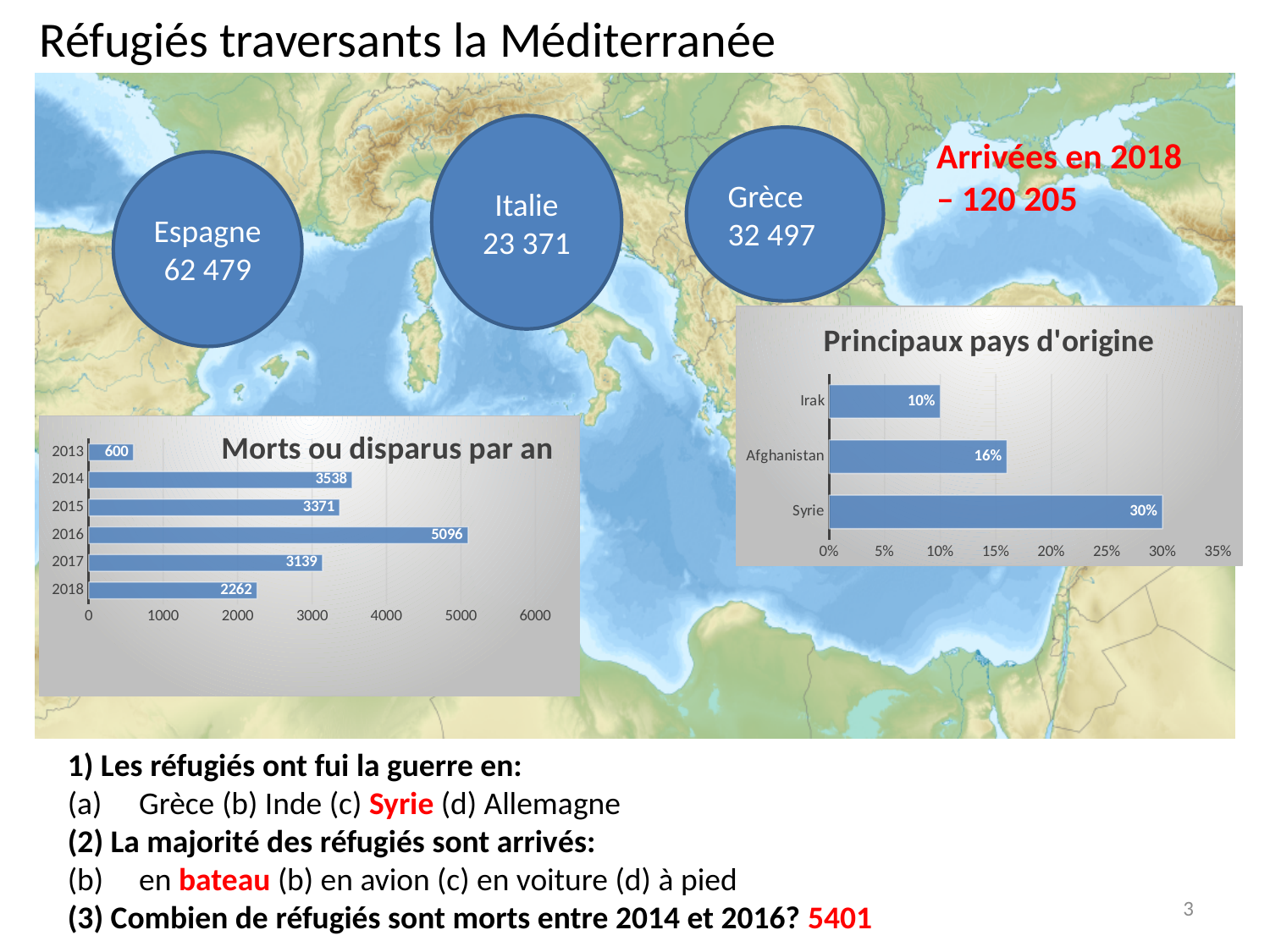
In the 'Morts ou disparus par an' chart, which year has the lowest value? 2013 In the 'Morts ou disparus par an' chart, what is the value for 2013? 600 In the 'Principaux pays d'origine' chart, how many countries are shown? 3 In the 'Morts ou disparus par an' chart, which is larger, the value for 2015 or the value for 2017? 2015 In the 'Morts ou disparus par an' chart, what is the difference between the values for 2014 and 2018? 1276 In the 'Principaux pays d'origine' chart, what is the value for Afghanistan? 16% In the 'Principaux pays d'origine' chart, what is the difference between the values for Syrie and Irak? 20% What kind of chart is 'Morts ou disparus par an'? Bar chart In the 'Morts ou disparus par an' chart, which year has the highest value? 2016 In the 'Principaux pays d'origine' chart, which country has the highest value? Syrie In the 'Morts ou disparus par an' chart, how many years are shown? 6 In the 'Morts ou disparus par an' chart, what is the value for 2016? 5096